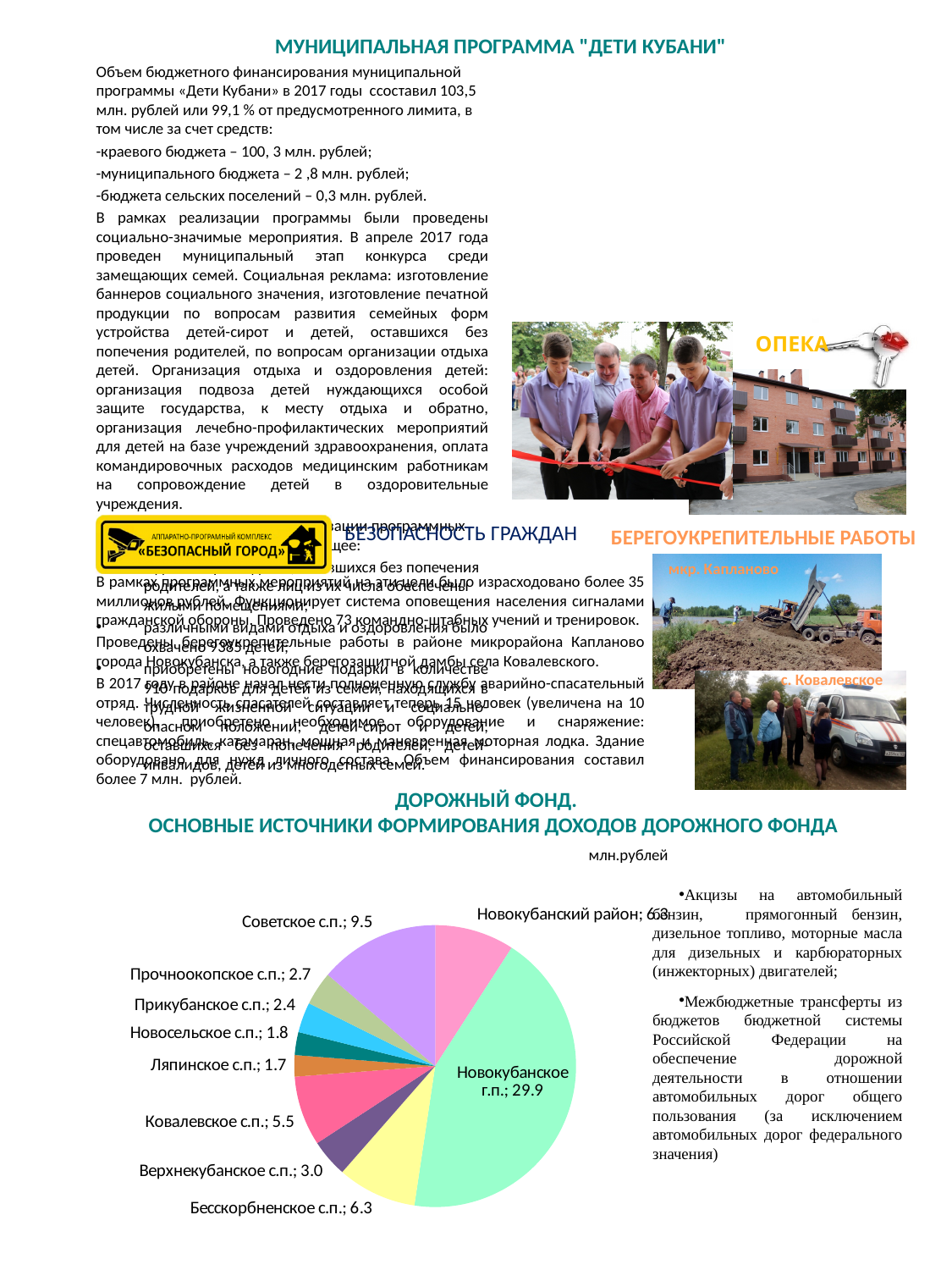
What is the value for Советское с.п. in the pie chart? 9.5 What is the value for Новокубанское г.п. in the pie chart? 29.9 What is the value for Бесскорбненское с.п. in the pie chart? 6.3 What is the difference between the values for Новокубанское г.п. and Советское с.п. in the pie chart? 20.4 What kind of chart is shown under the heading "ДОРОЖНЫЙ ФОНД"? pie chart Which is larger in the pie chart: Верхнекубанское с.п. or Прочноокопское с.п.? Верхнекубанское с.п. Which category has the largest slice in the pie chart? Новокубанское г.п. What is the value for Прикубанское с.п. in the pie chart? 2.4 How many categories (slices) does the pie chart have? 10 What is the value for Ковалевское с.п. in the pie chart? 5.5 Which category has the smallest value in the pie chart? Ляпинское с.п. In what units are the values of the pie chart given, according to the label above it? млн.рублей